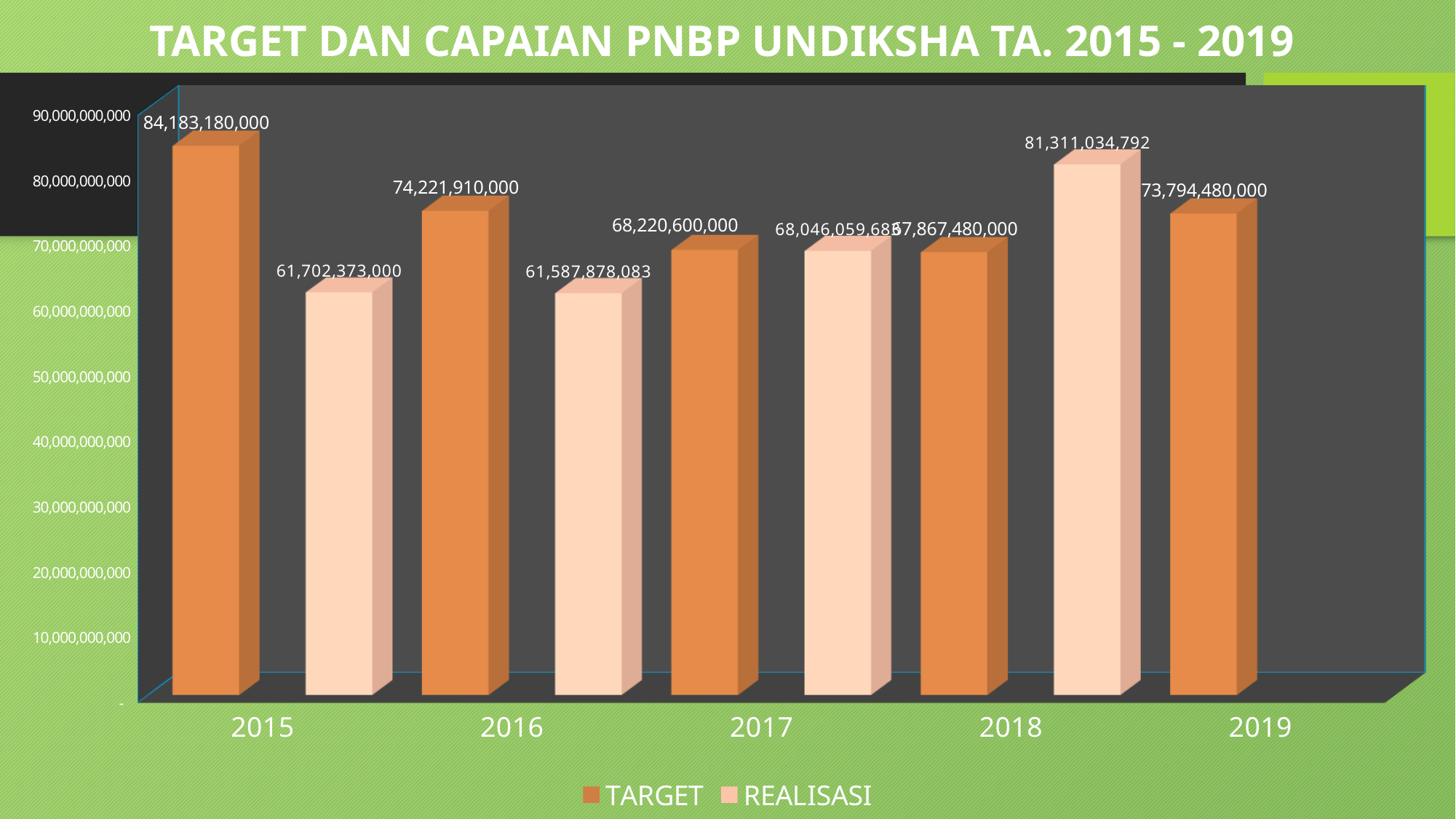
In which year is the TARGET value highest? 2015 What is the TARGET value for 2019? 73,794,480,000 What is the REALISASI value for 2015? 61,702,373,000 In which year is the TARGET value lowest? 2018 What kind of chart is shown on the slide? bar chart How many series does the legend list? 2 In 2018, which is larger, TARGET or REALISASI? REALISASI What is the TARGET value for 2015? 84,183,180,000 Does the TARGET value rise or fall from 2015 to 2018? fall What is the difference between TARGET and REALISASI in 2015? 22,480,807,000 Is the REALISASI value for 2016 greater or less than 70,000,000,000? less What is the REALISASI value for 2018? 81,311,034,792